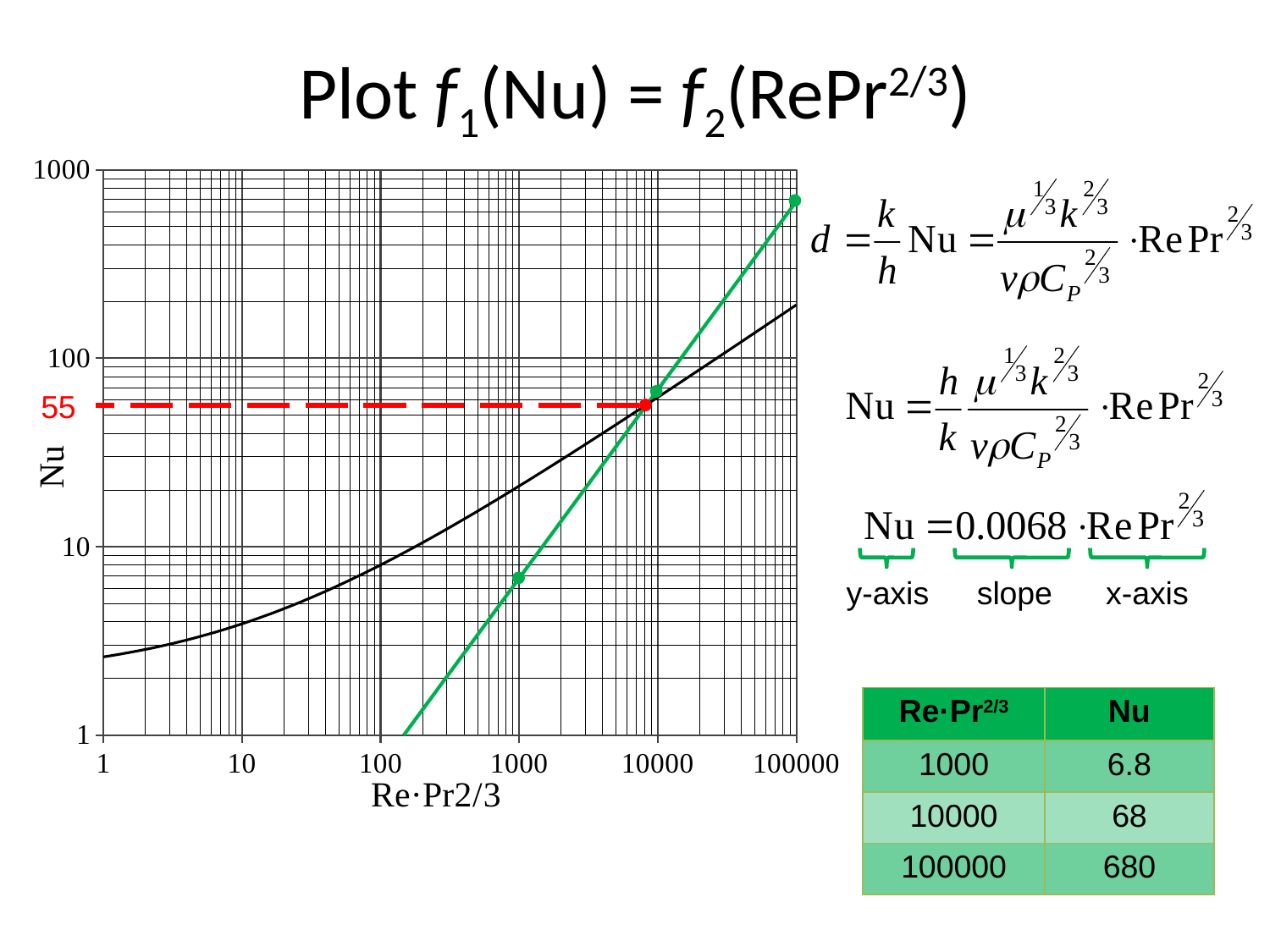
What is the Nu value of the green line at Re·Pr2/3 = 1000? 6.8 At what Nu value is the red dashed horizontal line drawn? 55 Does the green line rise or fall as Re·Pr2/3 increases? rises What is the difference between the Nu values of the green line at Re·Pr2/3 = 100000 and at Re·Pr2/3 = 10000? 612 Is the value of the black curve at Re·Pr2/3 = 100000 greater or less than 100? greater How many marked data points are on the green line? 3 What is the label of the y axis of the chart? Nu What is the label of the x axis of the chart? Re·Pr2/3 At Re·Pr2/3 = 1000, which is higher, the black curve or the green line? the black curve What is the Nu value of the green line at Re·Pr2/3 = 10000? 68 What is the Nu value of the green line at Re·Pr2/3 = 100000? 680 What kind of chart is shown on the slide? line chart